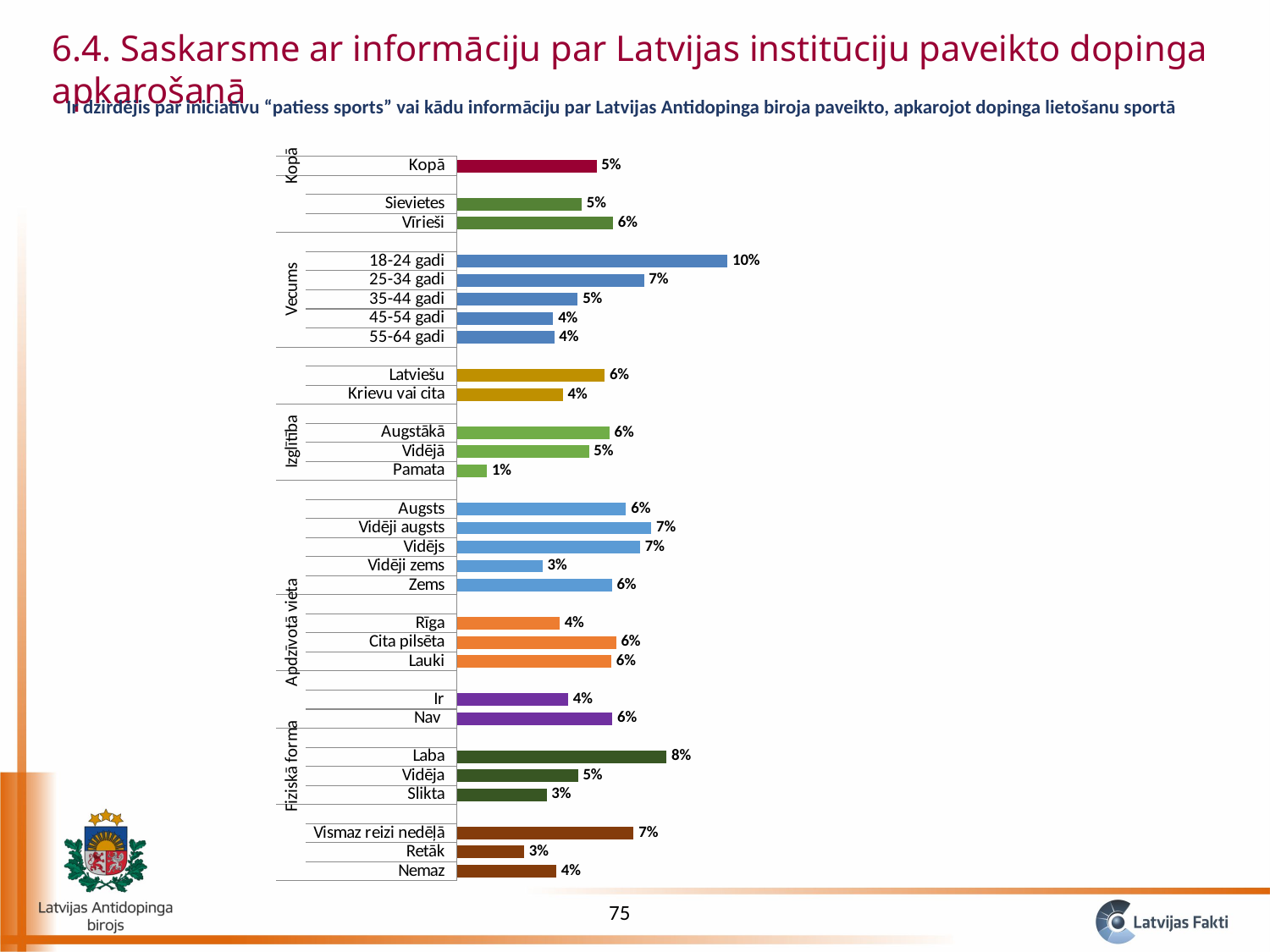
What is the value for 18-24 gadi? 10% Which category has the lowest value? Pamata Which is larger, the value for Rīga or the value for Lauki? Lauki What is the value for Kopā? 5% What is the value for Laba? 8% What is the difference between the values for 18-24 gadi and 55-64 gadi? 6% What is the value for Pamata? 1% What is the value for Vismaz reizi nedēļā? 7% What is the difference between the values for Laba and Slikta? 5% Which category has the highest value? 18-24 gadi How many categories are plotted in the chart? 29 What kind of chart is shown on the slide? bar chart